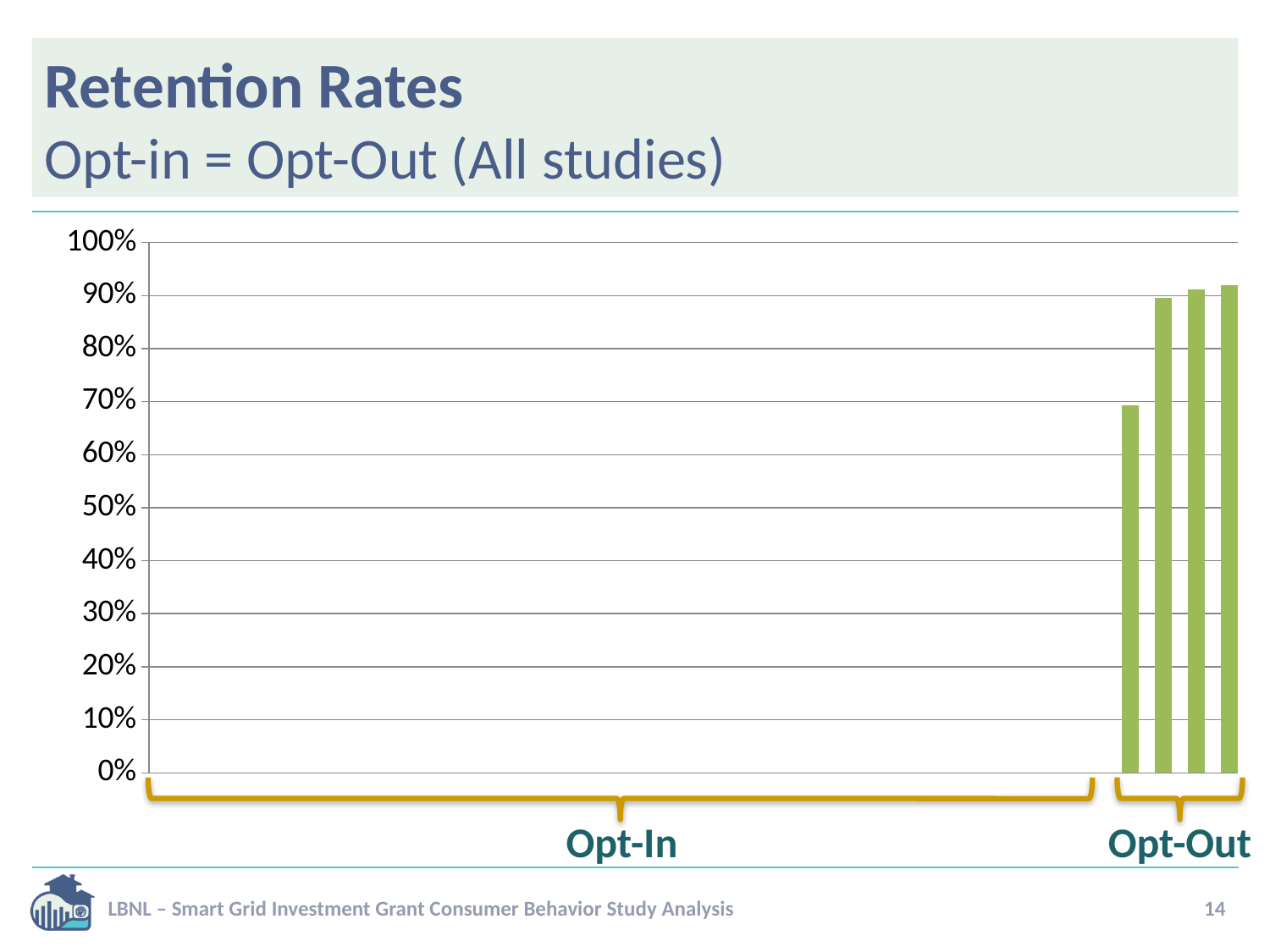
Is the value of the leftmost bar in the Opt-Out group greater or less than 60%? greater What is the highest value shown on the vertical axis? 100% What kind of chart is shown on the slide? bar chart Is the value of the rightmost bar in the Opt-Out group greater or less than 80%? greater Do the bars in the Opt-Out group rise or fall from left to right? rise Which bar in the Opt-Out group is the lowest: the leftmost or the rightmost? the leftmost What are the two group labels shown beneath the x axis? Opt-In and Opt-Out How many bars are plotted in the Opt-Out group? 4 Is the value of the leftmost bar in the Opt-Out group greater or less than 80%? less Which is larger: the leftmost bar in the Opt-Out group or the second bar from the left in the Opt-Out group? the second bar from the left